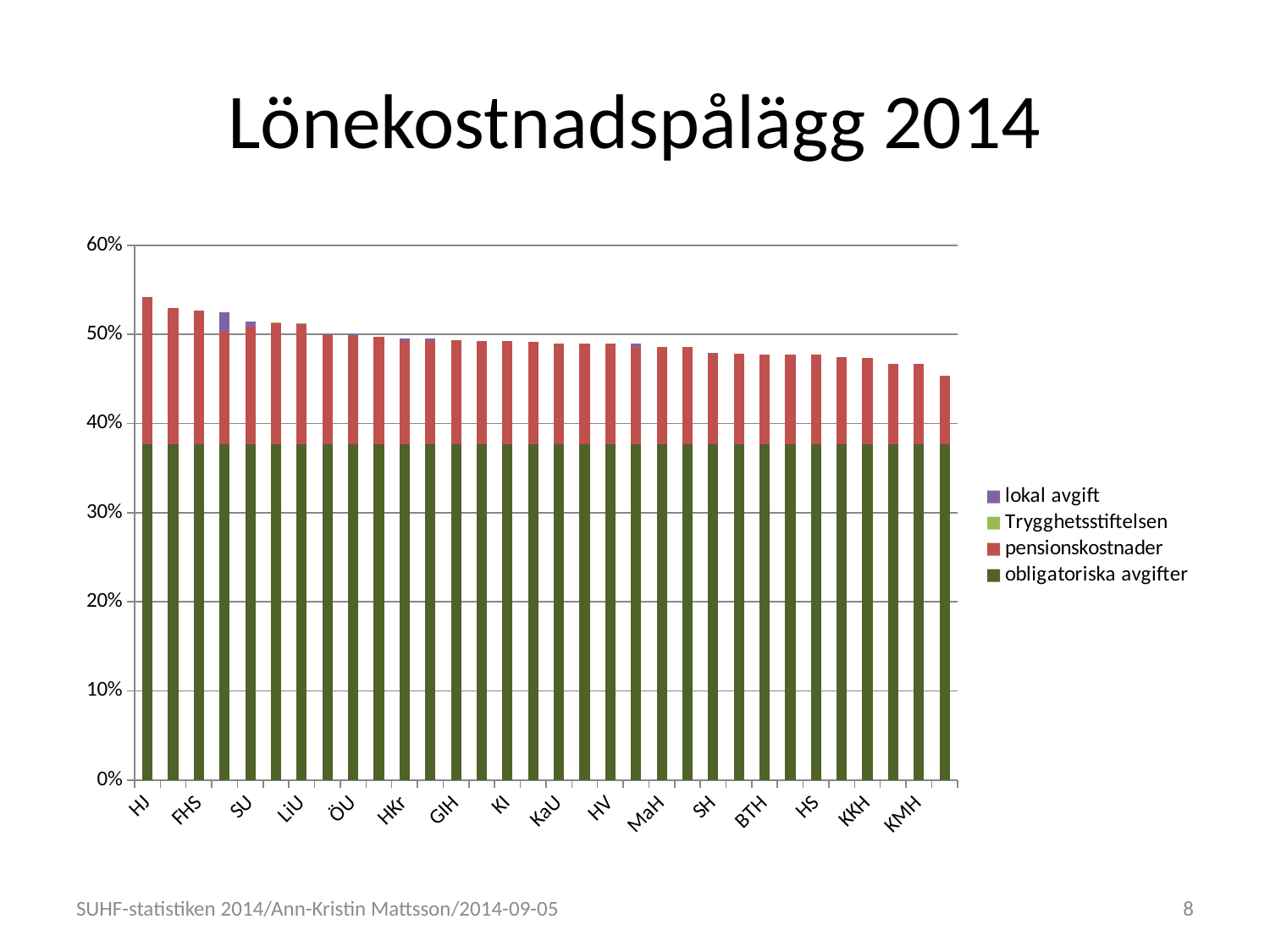
How many series does the legend list? 4 Is the total value for KMH greater or less than 50%? less Is the total value for HJ greater or less than 50%? greater Which has the larger total bar, SU or HS? SU What is the title of the chart? Lönekostnadspålägg 2014 Is the total value for FHS greater or less than 50%? greater What kind of chart is shown on the slide? Stacked bar chart Which series is shown in dark green at the bottom of each bar? obligatoriska avgifter Which has the larger total bar, HJ or KMH? HJ Which category has the highest total bar? HJ Do the total bar values rise or fall from left to right along the x axis? Fall